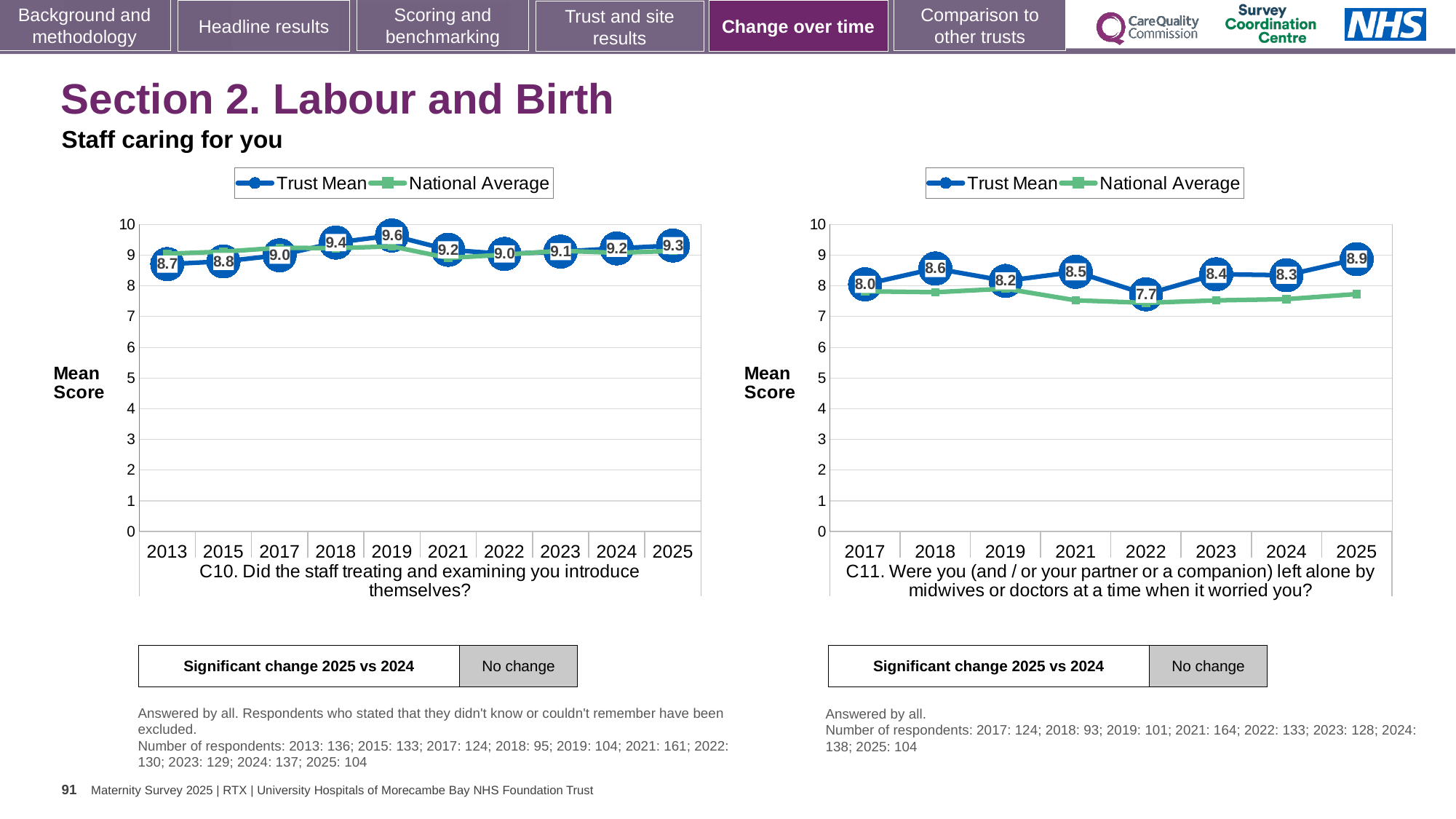
In the C10 chart on the left, what is the Trust Mean score for 2013? 8.7 In the C11 chart on the right, which year has the lowest Trust Mean score? 2022 In the C11 chart on the right, is the National Average value for 2022 greater or less than 8? less In the C10 chart on the left, which year has the lowest Trust Mean score? 2013 In the C10 chart on the left, what is the difference between the Trust Mean scores for 2025 and 2024? 0.1 In the C11 chart on the right, which year has the highest Trust Mean score? 2025 In the C11 chart on the right, is the Trust Mean score for 2018 or 2019 larger? 2018 How many series does the legend of the C11 chart on the right list? 2 In the C10 chart on the left, which year has the highest Trust Mean score? 2019 In the C11 chart on the right, what is the Trust Mean score for 2022? 7.7 How many years are plotted on the x axis of the C10 chart on the left? 10 In the C10 chart on the left, what is the Trust Mean score for 2019? 9.6